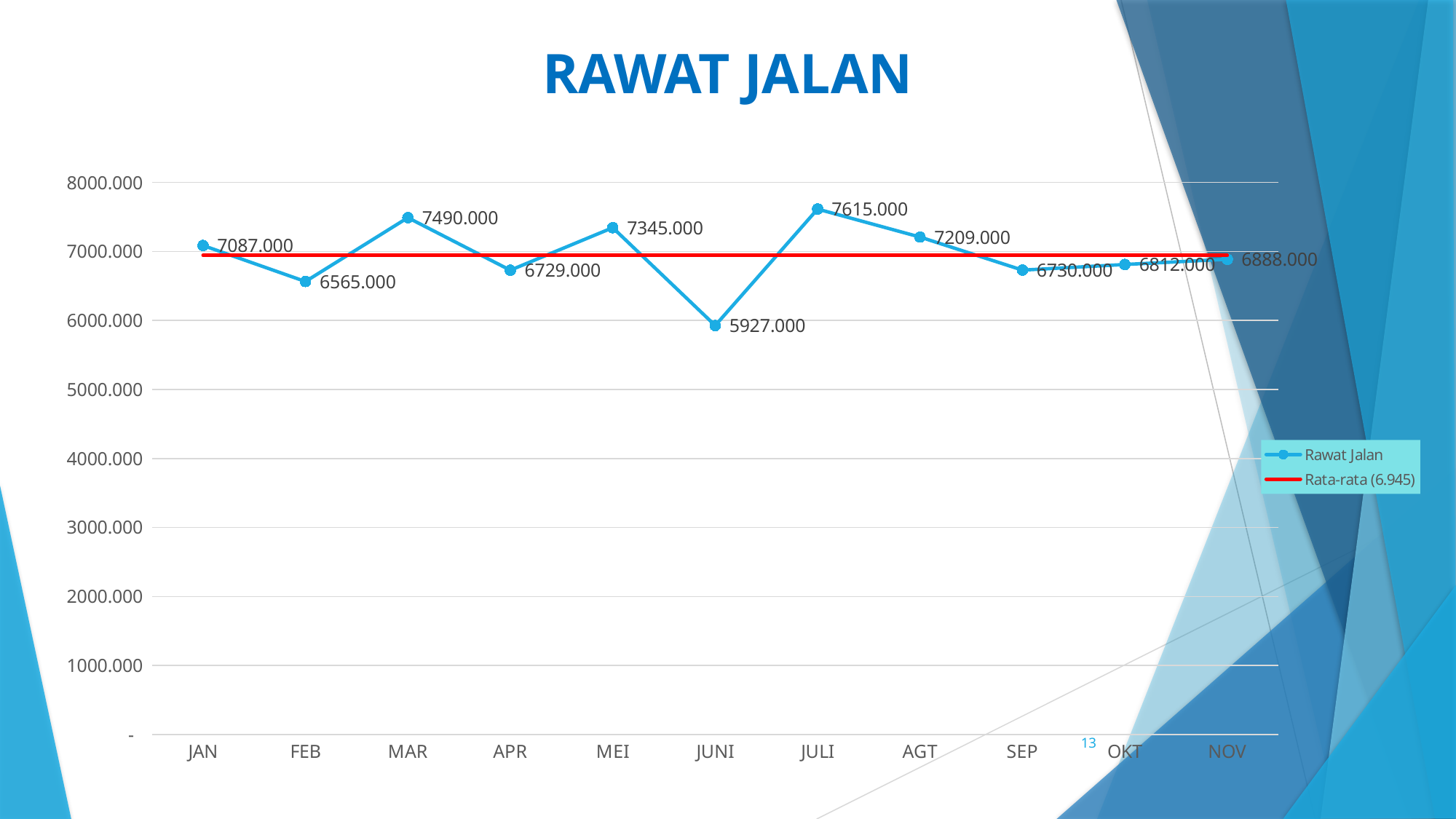
How many months are plotted on the x axis? 11 Which month has the highest Rawat Jalan value? JULI What is the Rawat Jalan value for MAR? 7490.000 How many series does the legend list? 2 Which month has the lowest Rawat Jalan value? JUNI What is the Rawat Jalan value for NOV? 6888.000 Which month has a larger Rawat Jalan value, FEB or MEI? MEI What type of chart is shown on the slide? line chart What is the Rawat Jalan value for JUNI? 5927.000 What is the difference between the Rawat Jalan values for JULI and JUNI? 1688.000 Is the Rawat Jalan value for JUNI greater or less than 6000.000? less What is the title of the chart? RAWAT JALAN